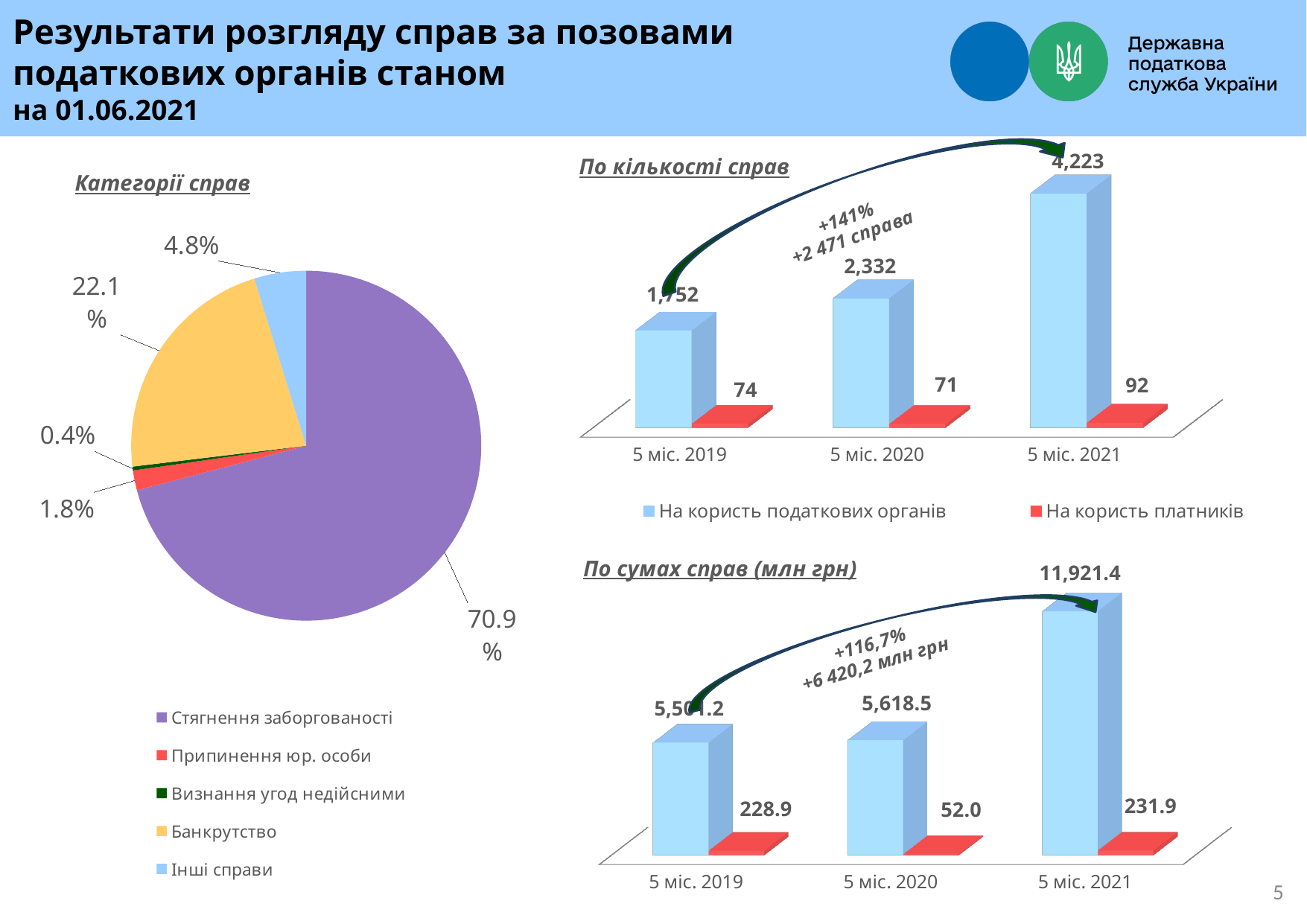
In the chart 'По кількості справ', do the 'На користь податкових органів' values rise or fall from 5 міс. 2019 to 5 міс. 2021? rise What kind of chart is 'По сумах справ (млн грн)'? bar chart How many series does the legend of the chart 'По кількості справ' list? 2 In the chart 'По кількості справ', what is the value for 'На користь платників' in 5 міс. 2020? 71 In the chart 'По кількості справ', what is the value for 'На користь податкових органів' in 5 міс. 2021? 4,223 In the pie chart 'Категорії справ', what share does 'Банкрутство' have? 22.1% How many categories does the legend of the pie chart 'Категорії справ' list? 5 In the chart 'По сумах справ (млн грн)', which period has the lowest value for 'На користь платників'? 5 міс. 2020 In the chart 'По сумах справ (млн грн)', what is the value for 'На користь податкових органів' in 5 міс. 2021? 11,921.4 In the pie chart 'Категорії справ', which category has the smallest share? Визнання угод недійсними In the pie chart 'Категорії справ', which category has the largest share? Стягнення заборгованості In the chart 'По кількості справ', what is the difference between the 'На користь податкових органів' values for 5 міс. 2021 and 5 міс. 2020? 1,891